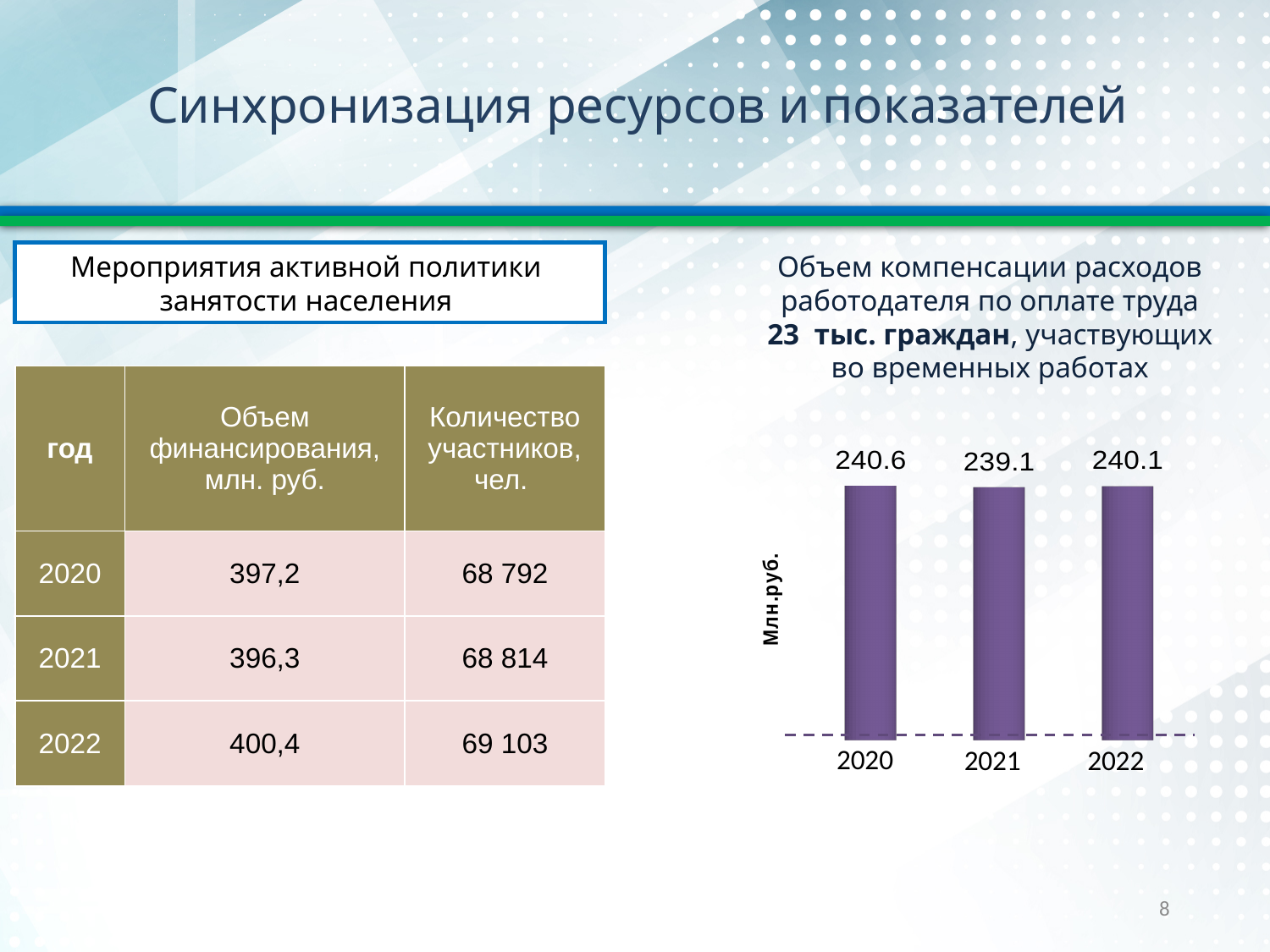
Which year has the lowest value in the bar chart? 2021 What type of chart is shown on the slide? bar chart Which year has the highest value in the bar chart? 2020 What is the value for 2022 in the bar chart? 240.1 What colour are the bars in the chart? purple Which is larger in the bar chart, the value for 2020 or the value for 2022? 2020 What is the label on the vertical axis of the bar chart? Млн.руб. What is the value for 2021 in the bar chart? 239.1 What is the difference between the values for 2020 and 2021 in the bar chart? 1.5 What is the value for 2020 in the bar chart? 240.6 What is the difference between the values for 2022 and 2021 in the bar chart? 1.0 How many bars are shown in the bar chart? 3